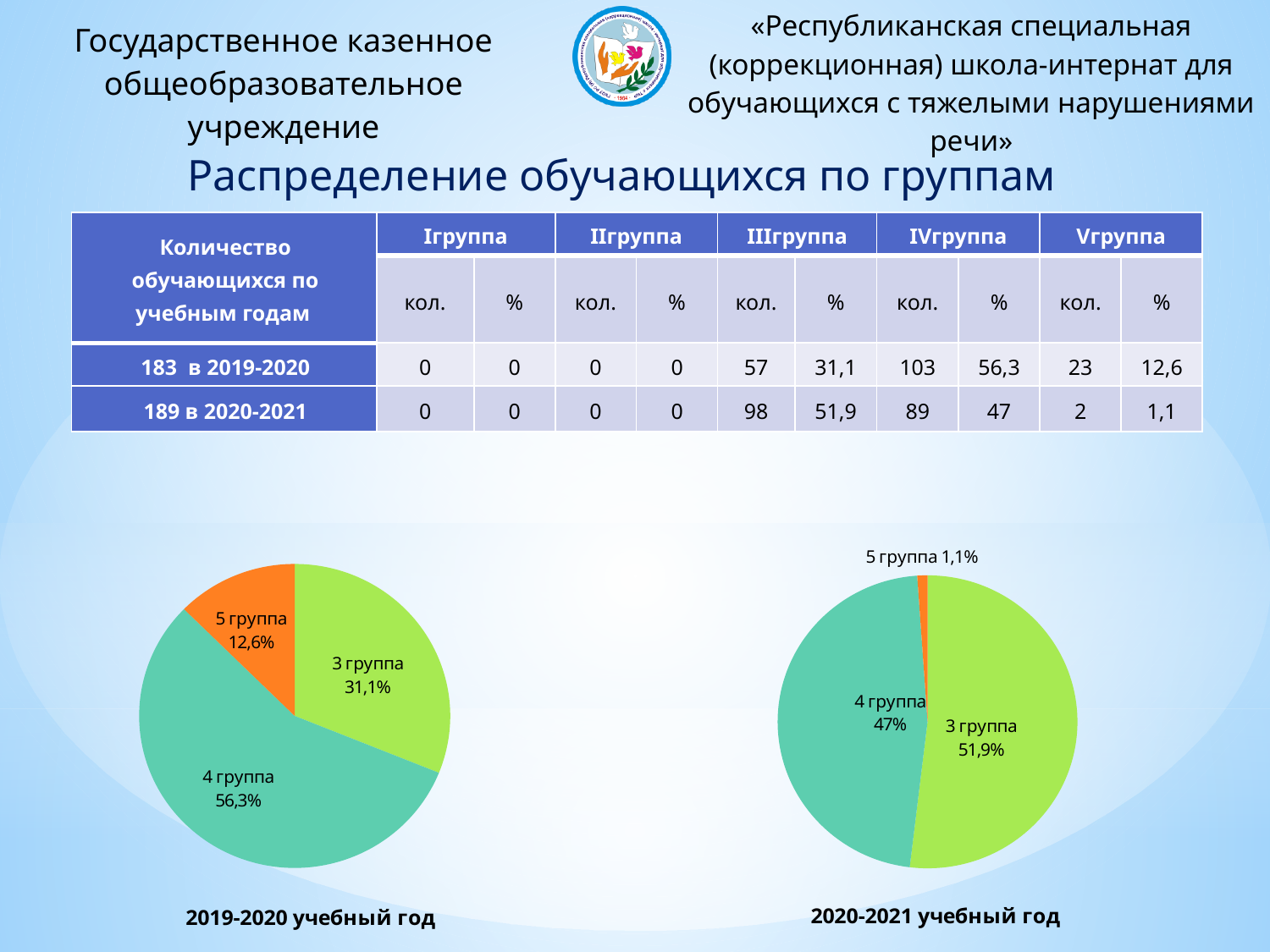
In the 2019-2020 учебный год pie chart, what share does 3 группа have? 31,1% How many slices does the 2020-2021 учебный год pie chart have? 3 In the 2019-2020 учебный год pie chart, which group has the largest slice? 4 группа In the 2019-2020 учебный год pie chart, what share does 4 группа have? 56,3% In the 2020-2021 учебный год pie chart, what share does 3 группа have? 51,9% What colour is the 5 группа slice in the 2019-2020 учебный год pie chart? Orange What type of chart is used for the 2019-2020 учебный год data? Pie chart In the 2020-2021 учебный год pie chart, which is larger: 3 группа or 4 группа? 3 группа In the 2020-2021 учебный год pie chart, which group has the smallest slice? 5 группа In the 2019-2020 учебный год pie chart, what share does 5 группа have? 12,6% In the 2020-2021 учебный год pie chart, what share does 5 группа have? 1,1% In the 2019-2020 учебный год pie chart, what is the difference between the shares of 4 группа and 3 группа? 25,2%